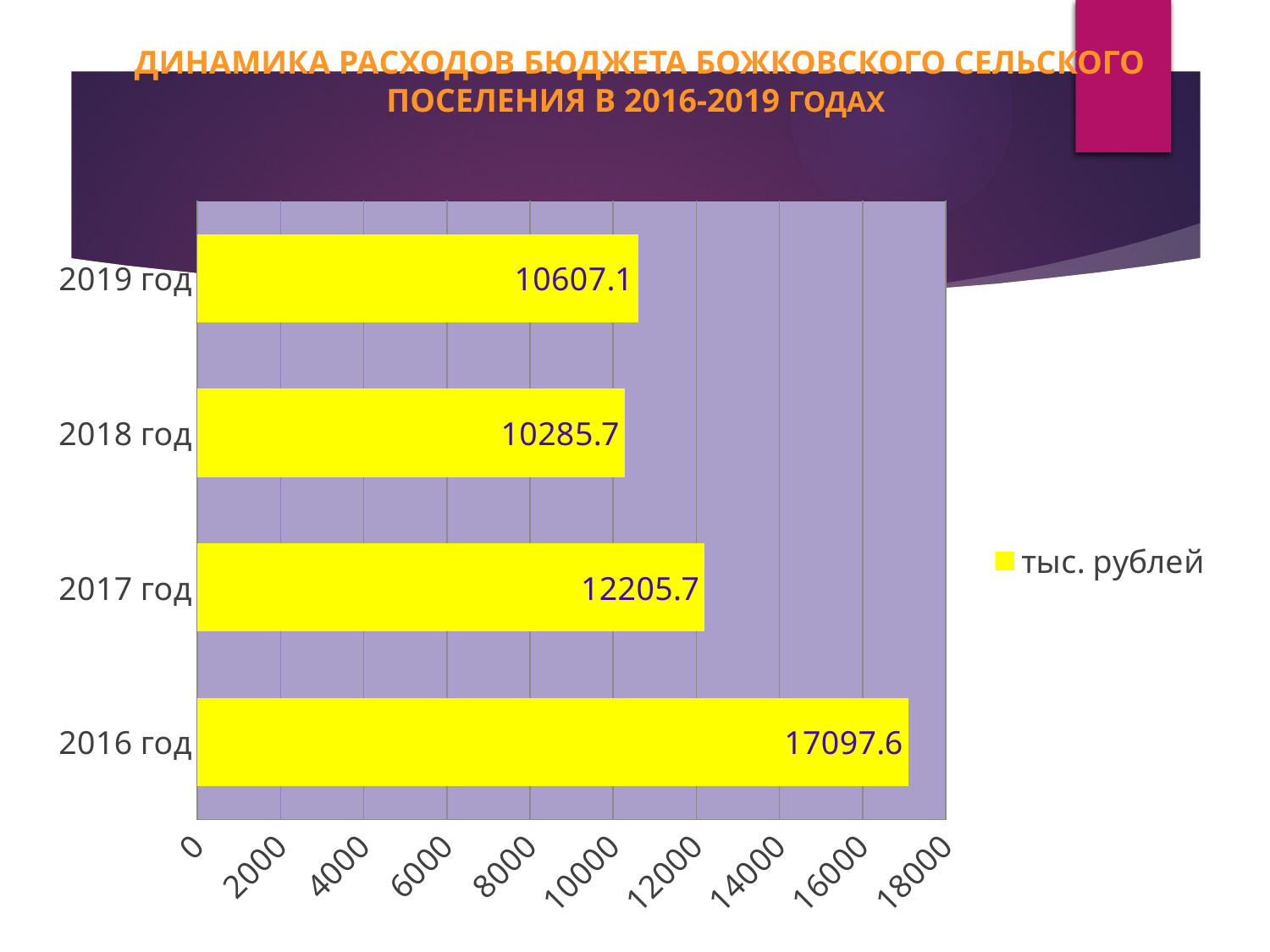
What is the difference between the values for 2016 год and 2017 год? 4891.9 What is the value for 2016 год? 17097.6 Which is larger, the value for 2017 год or the value for 2019 год? 2017 год What is the legend entry of the chart? тыс. рублей What is the value for 2019 год? 10607.1 Is the value for 2016 год greater or less than 16000? greater How many years are shown in the chart? 4 What kind of chart is shown on the slide? bar chart What is the difference between the values for 2019 год and 2018 год? 321.4 Which year has the lowest value? 2018 год What is the value for 2018 год? 10285.7 Which year has the highest value? 2016 год